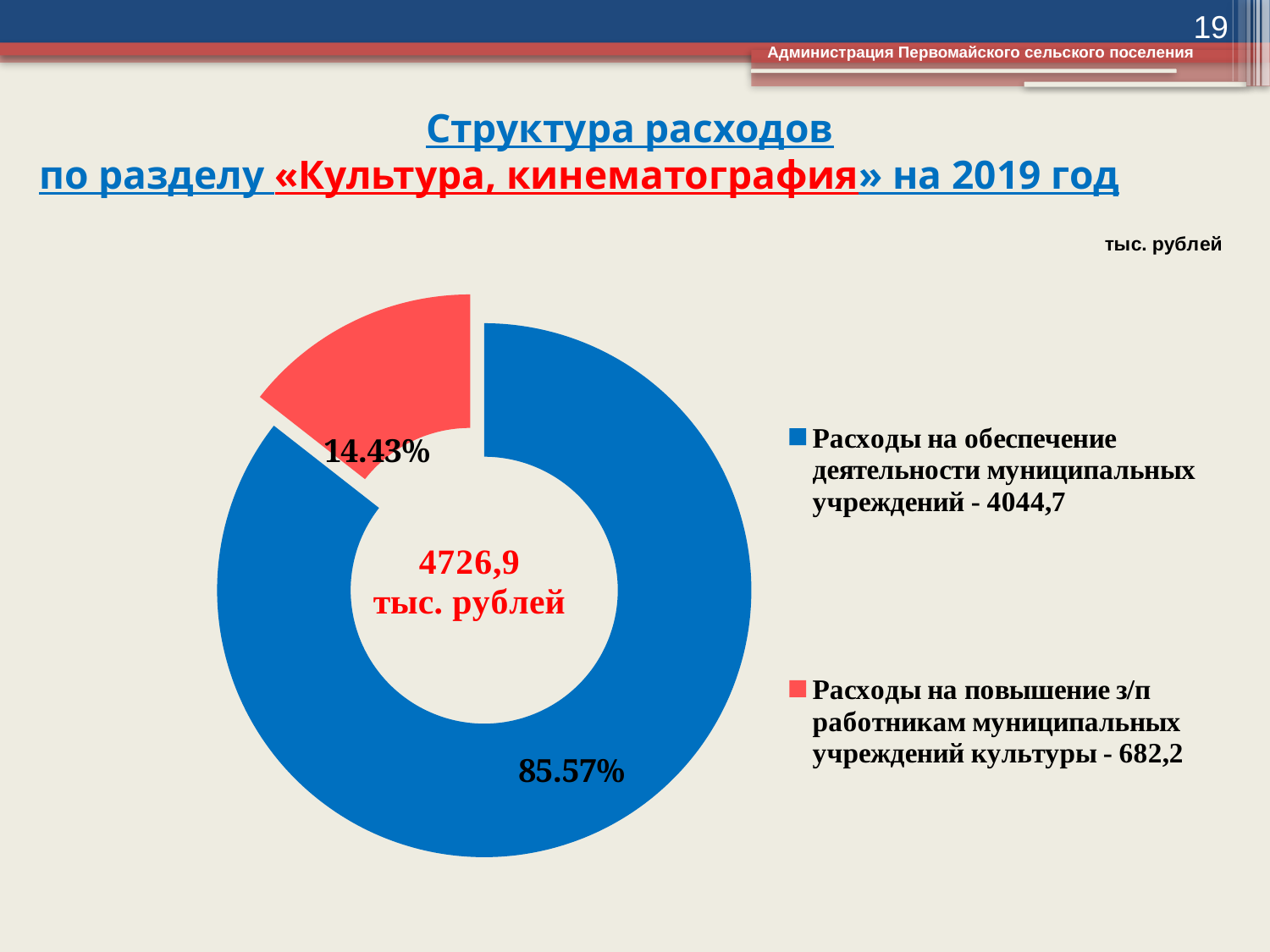
What is the difference between the values 4044,7 and 682,2 shown in the legend? 3362,5 What share of the pie does the slice for 'Расходы на повышение з/п работникам муниципальных учреждений культуры' take? 14.43% What share of the pie does the slice for 'Расходы на обеспечение деятельности муниципальных учреждений' take? 85.57% Which category has the largest slice of the pie? Расходы на обеспечение деятельности муниципальных учреждений How many slices does the pie chart have? 2 What kind of chart is shown on the slide? Pie chart (doughnut) What value is given in the legend for 'Расходы на обеспечение деятельности муниципальных учреждений'? 4044,7 What is the difference in percentage points between the two slices of the pie? 71.14 What total is printed in the centre of the doughnut chart? 4726,9 тыс. рублей Which category has the smallest slice of the pie? Расходы на повышение з/п работникам муниципальных учреждений культуры What colour is the slice for 'Расходы на повышение з/п работникам муниципальных учреждений культуры'? Red What value is given in the legend for 'Расходы на повышение з/п работникам муниципальных учреждений культуры'? 682,2